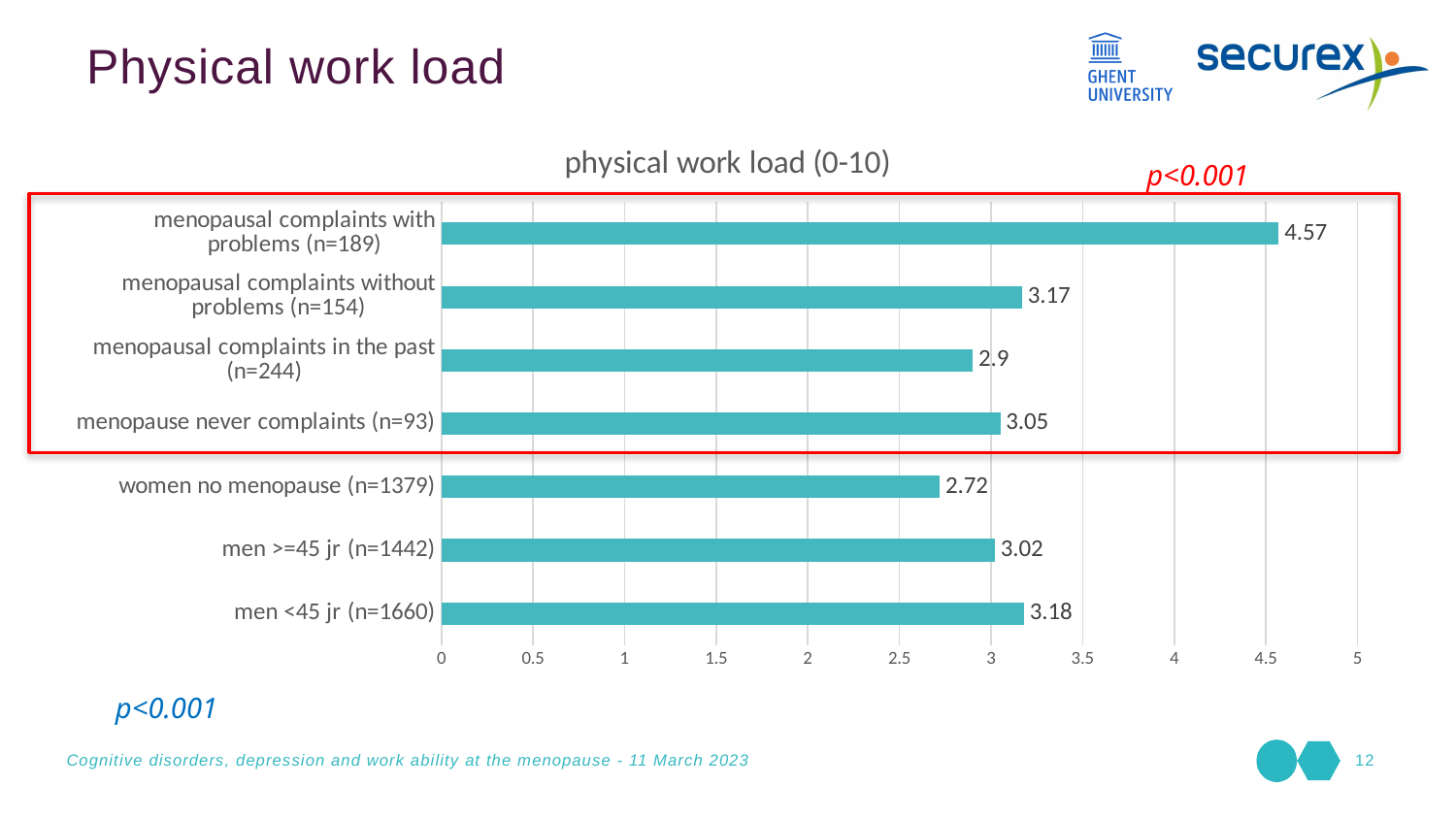
What is the physical work load value for menopausal complaints with problems (n=189)? 4.57 Is the physical work load for menopausal complaints with problems (n=189) greater or less than 4? greater What type of chart is shown on the slide? bar chart Which category has the lowest physical work load? women no menopause (n=1379) Which has a higher physical work load: men >=45 jr (n=1442) or menopause never complaints (n=93)? menopause never complaints (n=93) What is the physical work load value for women no menopause (n=1379)? 2.72 Which category has the highest physical work load? menopausal complaints with problems (n=189) How many categories are shown in the chart? 7 What is the physical work load value for menopausal complaints in the past (n=244)? 2.9 What is the title of the chart? physical work load (0-10) What is the physical work load value for men <45 jr (n=1660)? 3.18 What is the difference between the physical work load for menopausal complaints with problems (n=189) and menopausal complaints without problems (n=154)? 1.4